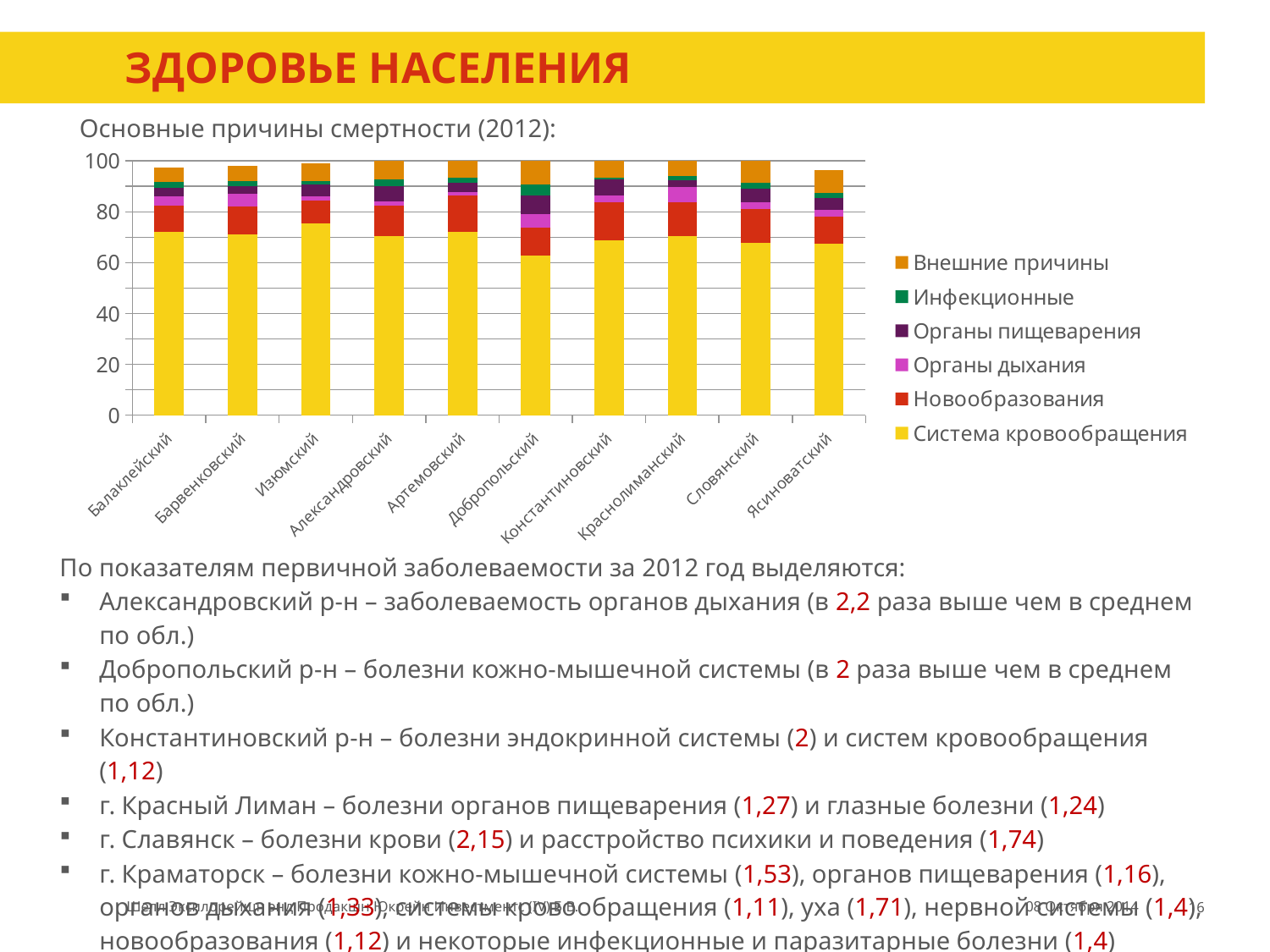
Is the value of Система кровообращения for Балаклейский greater or less than 80? less Is the value of Система кровообращения for Изюмский greater or less than 60? greater How many districts (categories) are shown on the x axis of the chart? 10 Which district has the smallest Система кровообращения segment? Добропольский What kind of chart is shown on the slide? Stacked bar chart Which legend entry is shown in orange? Внешние причины Is the value of Система кровообращения for Добропольский greater or less than 80? less Which district has the largest Система кровообращения segment? Изюмский Which district has the larger Система кровообращения segment, Добропольский or Изюмский? Изюмский How many series does the chart legend list? 6 Which district has the larger Внешние причины segment, Добропольский or Балаклейский? Добропольский What is the title of the chart? Основные причины смертности (2012):